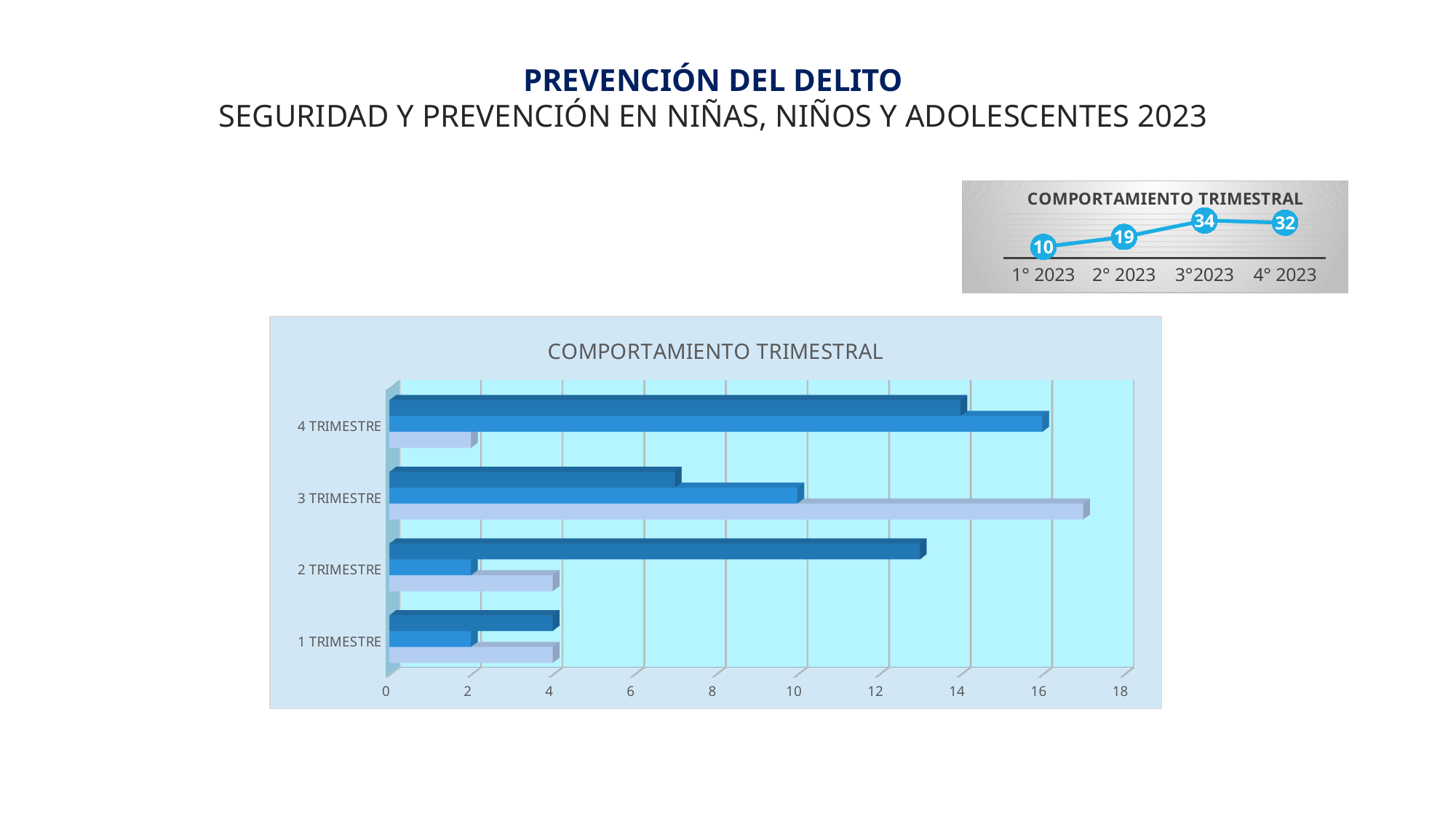
In the line chart at the top right, do the values rise or fall from 1° 2023 to 3°2023? rise In the bar chart, is the value of the dark blue bar for 2 TRIMESTRE greater or less than 12? greater In the line chart at the top right, how many data points are plotted? 4 In the bar chart, how many categories are shown on the vertical axis? 4 In the line chart at the top right, what is the value for 1° 2023? 10 In the line chart at the top right, which quarter has the highest value? 3°2023 What kind of chart is the large chart in the lower part of the slide? bar chart In the bar chart, is the value of the light lavender bar for 3 TRIMESTRE greater or less than 16? greater In the line chart at the top right, what is the difference between the values for 2° 2023 and 1° 2023? 9 In the line chart at the top right, which is larger: the value for 4° 2023 or the value for 2° 2023? 4° 2023 In the line chart at the top right, which quarter has the lowest value? 1° 2023 In the line chart at the top right, what is the value for 3°2023? 34